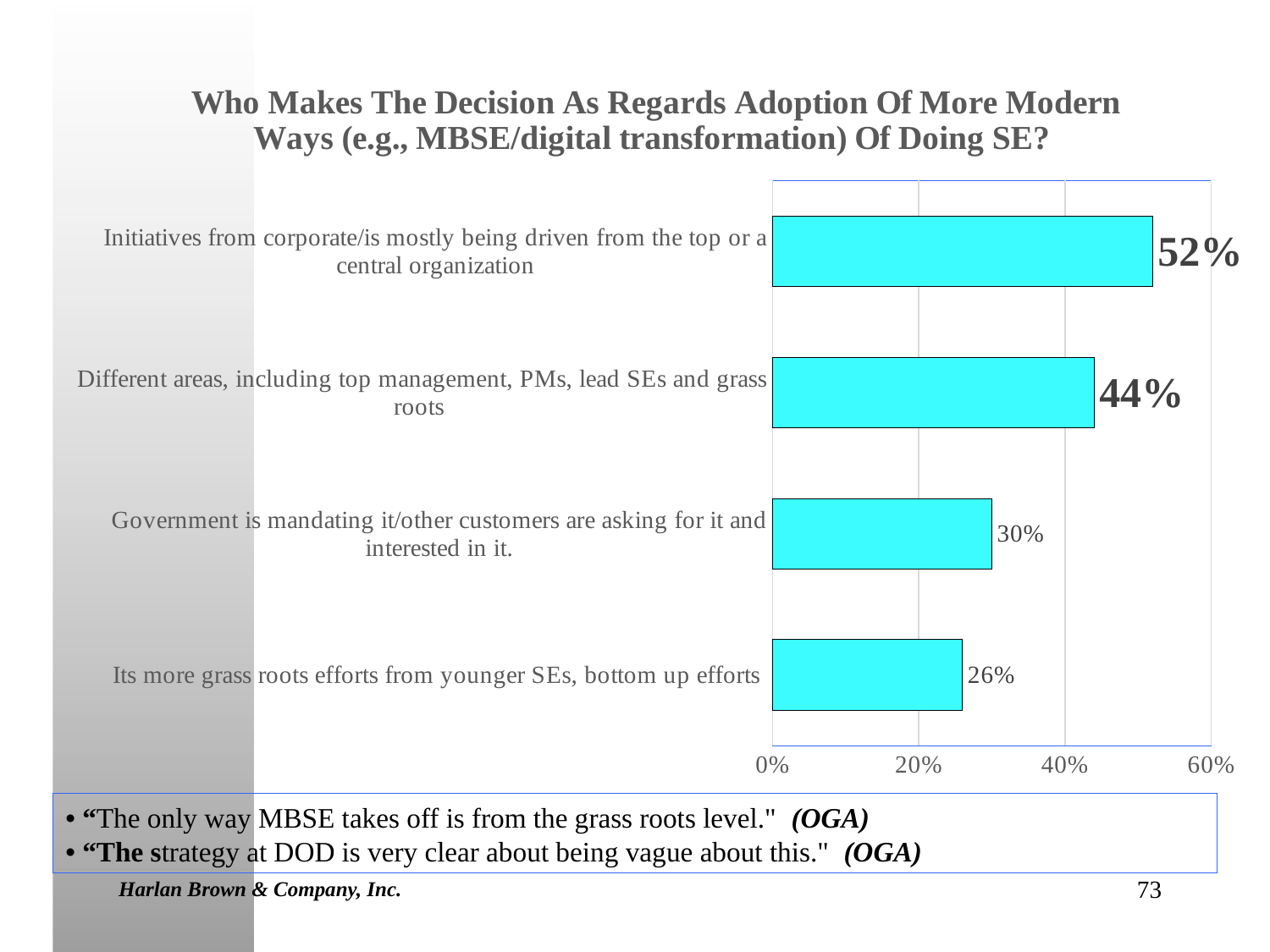
What is the maximum value shown on the horizontal axis? 60% Is the value for "Different areas, including top management, PMs, lead SEs and grass roots" greater or less than 40%? greater Which category has the lowest percentage? Its more grass roots efforts from younger SEs, bottom up efforts What kind of chart is shown on the slide? bar chart What is the title of the chart? Who Makes The Decision As Regards Adoption Of More Modern Ways (e.g., MBSE/digital transformation) Of Doing SE? What percentage is shown for "Government is mandating it/other customers are asking for it and interested in it."? 30% What percentage is shown for "Initiatives from corporate/is mostly being driven from the top or a central organization"? 52% What percentage is shown for "Its more grass roots efforts from younger SEs, bottom up efforts"? 26% Which category has the highest percentage? Initiatives from corporate/is mostly being driven from the top or a central organization What is the difference between the percentage for "Initiatives from corporate/is mostly being driven from the top or a central organization" and "Different areas, including top management, PMs, lead SEs and grass roots"? 8% Which is larger: the percentage for "Government is mandating it/other customers are asking for it and interested in it." or for "Its more grass roots efforts from younger SEs, bottom up efforts"? Government is mandating it/other customers are asking for it and interested in it. How many categories are shown in the chart? 4